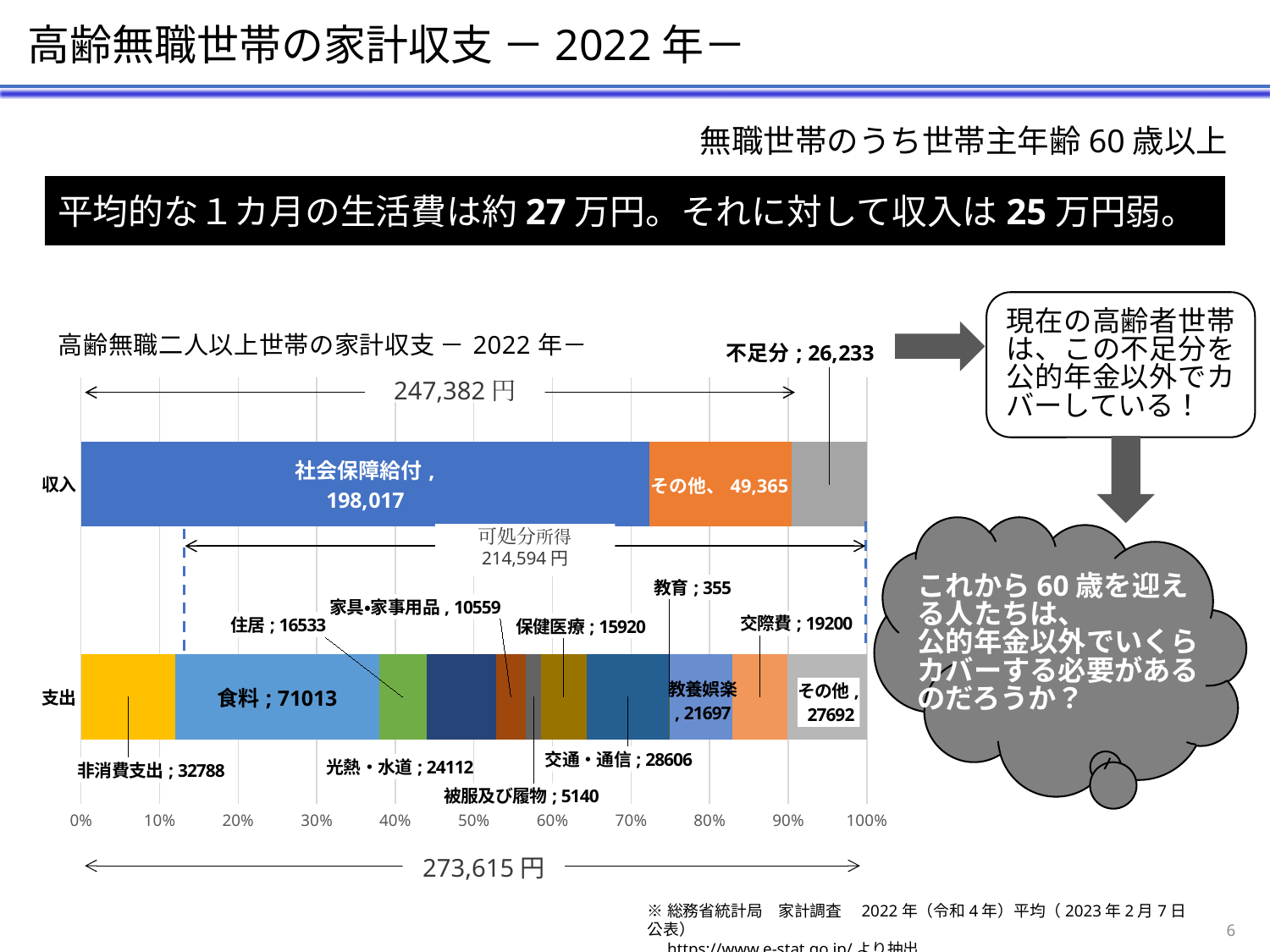
Which expenditure item in the 支出 bar has the smallest value? 教育 What is the title of the chart? 高齢無職二人以上世帯の家計収支 － 2022 年－ Which is larger in the 支出 bar: 光熱・水道 or 交際費? 光熱・水道 What is the value of 交通・通信 in the 支出 bar? 28606 How many expenditure items are labelled in the 支出 bar? 12 What is the difference between 社会保障給付 (198,017) and その他 (49,365) in the 収入 bar? 148,652 Which expenditure item in the 支出 bar has the largest value? 食料 What is the total of the 支出 bar as printed on the slide? 273,615 円 What is the value of 食料 in the 支出 bar? 71013 What type of chart is shown on the slide? Stacked bar chart What is the value of 社会保障給付 in the 収入 bar? 198,017 What is the value labelled 不足分? 26,233